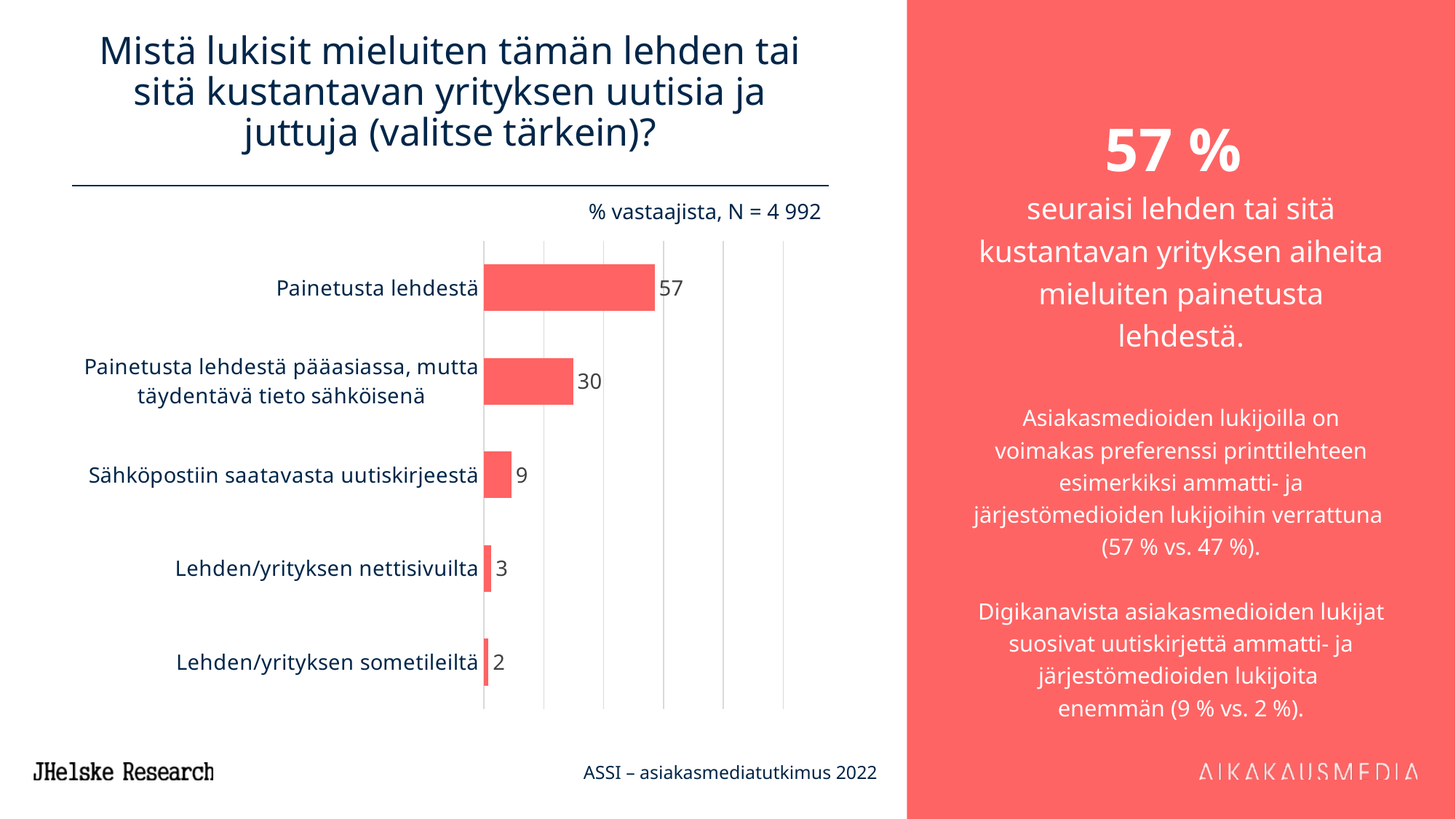
What is the value for "Painetusta lehdestä"? 57 Which is larger: the value for "Sähköpostiin saatavasta uutiskirjeestä" or for "Lehden/yrityksen nettisivuilta"? Sähköpostiin saatavasta uutiskirjeestä What is the difference between the values for "Painetusta lehdestä" and "Painetusta lehdestä pääasiassa, mutta täydentävä tieto sähköisenä"? 27 What is the value for "Lehden/yrityksen sometileiltä"? 2 What is the value for "Painetusta lehdestä pääasiassa, mutta täydentävä tieto sähköisenä"? 30 Which category has the highest value? Painetusta lehdestä What is the value for "Lehden/yrityksen nettisivuilta"? 3 What is the sample size (N) stated above the chart? 4 992 What is the value for "Sähköpostiin saatavasta uutiskirjeestä"? 9 What kind of chart is shown on the slide? Bar chart Which category has the lowest value? Lehden/yrityksen sometileiltä How many categories are shown in the chart? 5